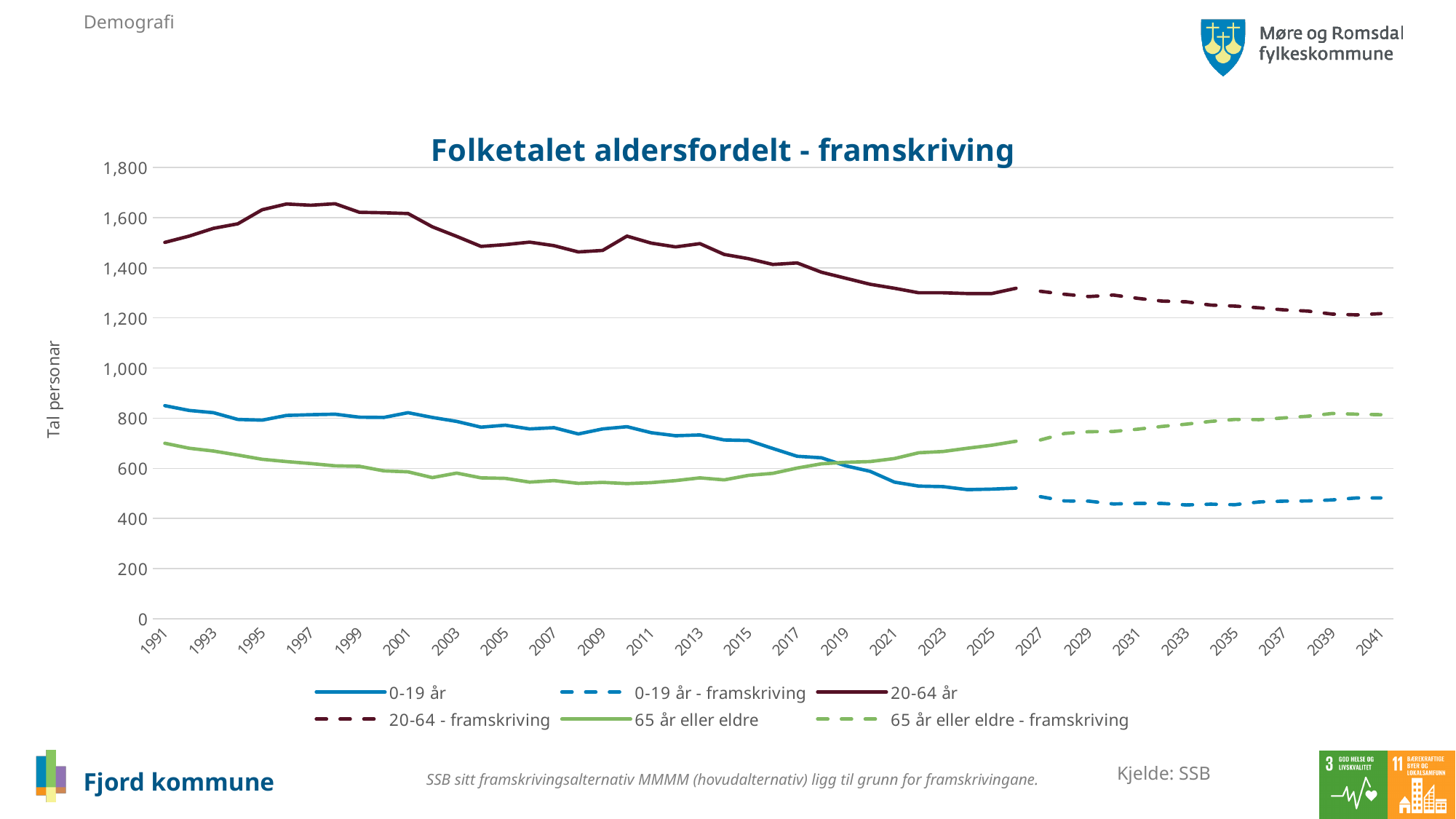
What is the label on the vertical axis? Tal personar Does the 65 år eller eldre series rise or fall between 2009 and 2025? rise Is the value for 65 år eller eldre - framskriving in 2041 greater or less than 600? greater Does the 20-64 år series rise or fall between 2001 and 2025? fall In 1991, which is larger: 0-19 år or 65 år eller eldre? 0-19 år What kind of chart is shown on the slide? line chart How many series does the legend list? 6 Which series has the highest values across the whole chart? 20-64 år What is the title of the chart? Folketalet aldersfordelt - framskriving Is the value for 20-64 år - framskriving in 2041 greater or less than 1,400? less Is the value for 0-19 år in 2025 greater or less than 600? less